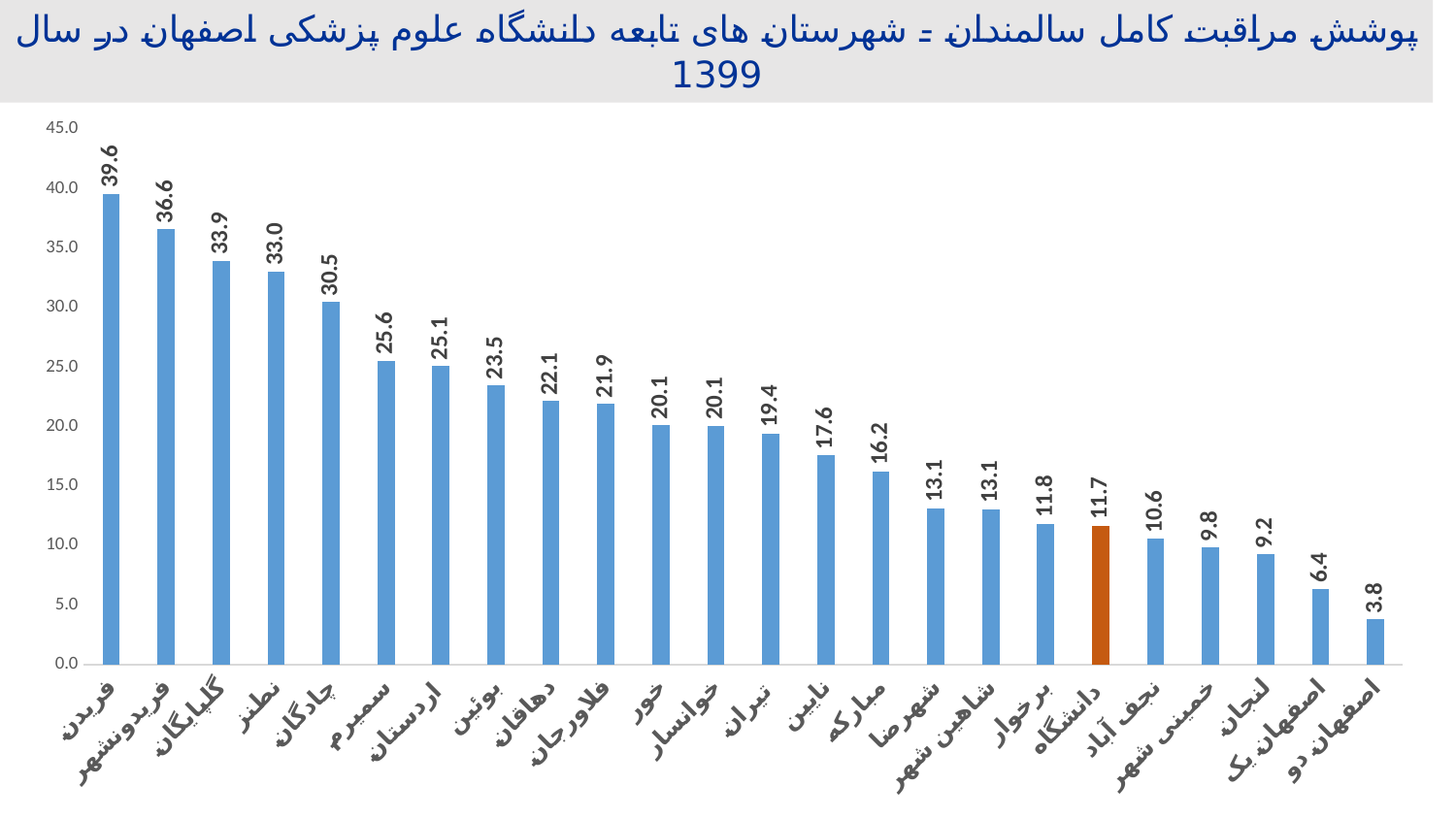
Which category has the highest value? فریدن What is the difference between the values for فریدن and فریدونشهر? 3.0 Which category has the lowest value? اصفهان دو Do the values rise or fall moving from left to right along the x axis? fall What kind of chart is shown on the slide? bar chart Which is larger, the value for چادگان or the value for سمیرم? چادگان How many categories (bars) are shown in the chart? 24 Is the value for نطنز greater or less than 30.0? greater What is the value for اصفهان دو? 3.8 Which bar is coloured orange instead of blue? دانشگاه What is the value for فریدن? 39.6 What is the value for دانشگاه (the orange bar)? 11.7